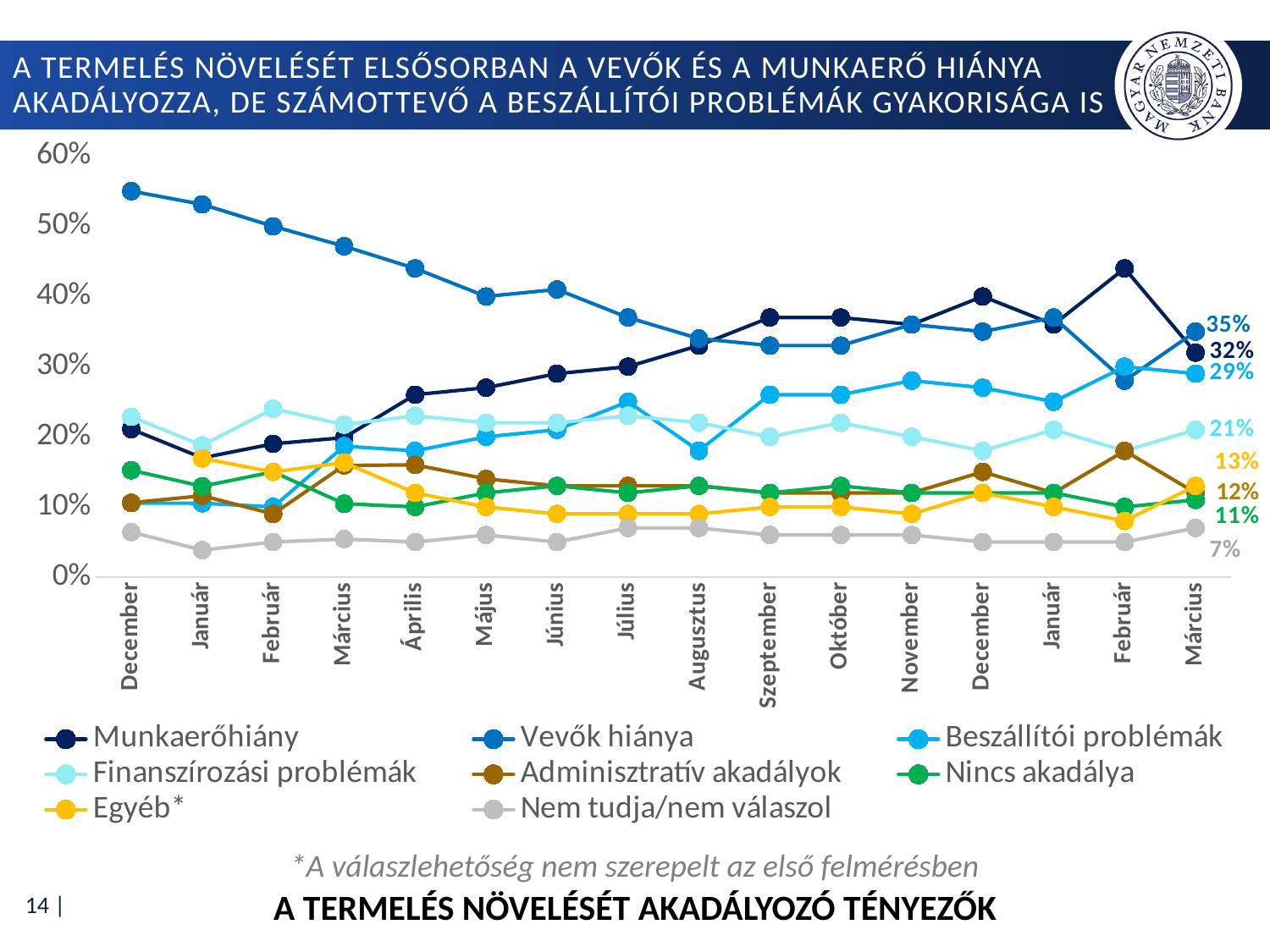
Does the Vevők hiánya line rise or fall from the first December to August? fall What is the value for Beszállítói problémák in the final March? 29% In the final March, which is larger: Finanszírozási problémák or Egyéb? Finanszírozási problémák Which series has the highest value in the final March? Vevők hiánya How many series does the legend list? 8 What is the value for Nem tudja/nem válaszol in the final March? 7% What is the value for Vevők hiánya in the final March? 35% Is the value for Vevők hiánya in the first December greater or less than 50%? greater How many months are shown along the x axis? 16 In the final March, how many percentage points higher is Vevők hiánya than Munkaerőhiány? 3 percentage points What is the value for Munkaerőhiány in the final March? 32% What kind of chart is shown on the slide? line chart